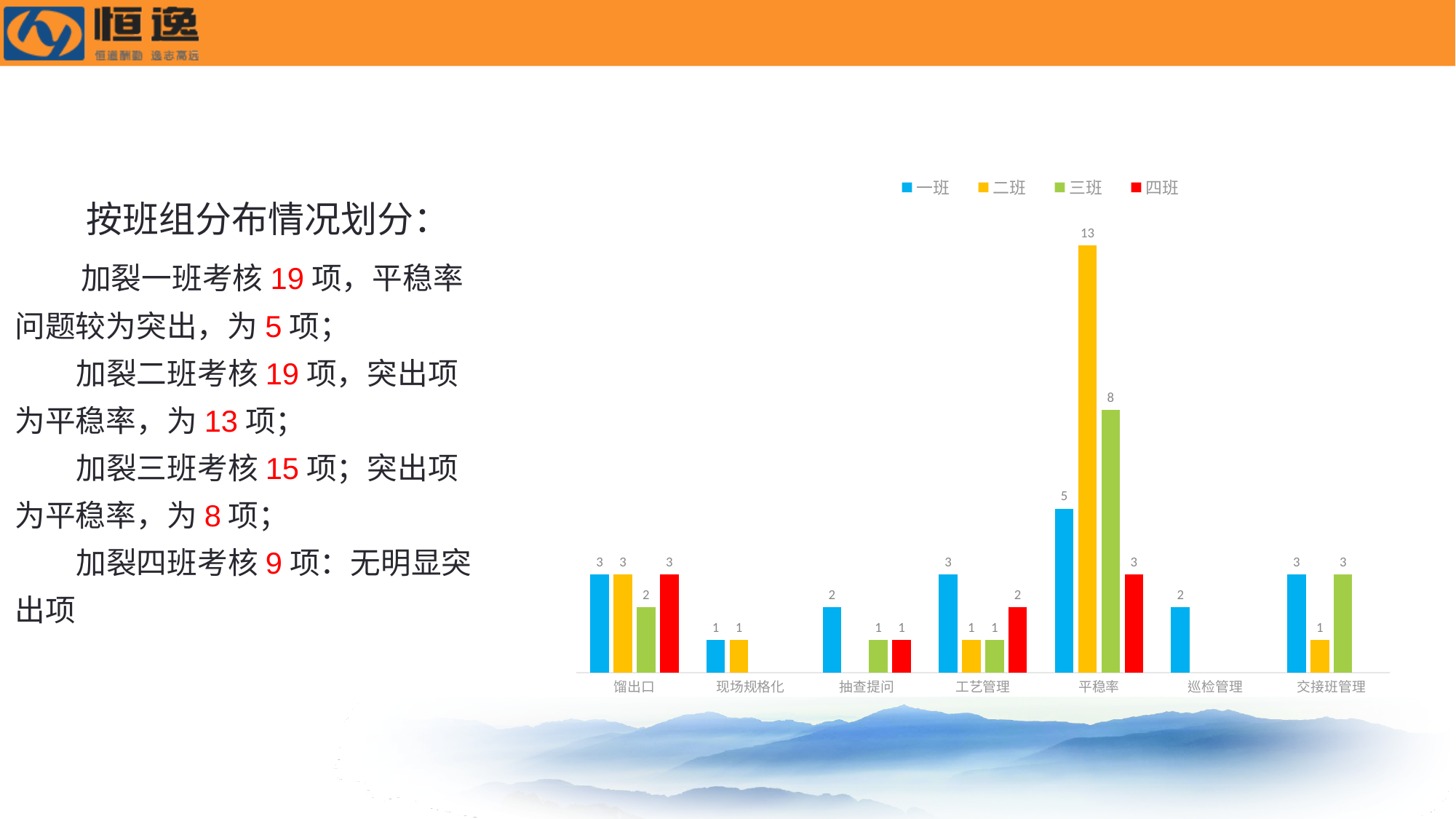
Which series is shown in red in the legend? 四班 What is the difference between the 二班 and 一班 values in the 平稳率 category? 8 How many categories are shown on the x axis? 7 How many series does the legend list? 4 What is the value for 三班 in the 平稳率 category? 8 What is the value for 二班 in the 平稳率 category? 13 Which series has the lowest value in the 馏出口 category? 三班 What is the value for 四班 in the 工艺管理 category? 2 Which is larger: the 一班 value for 抽查提问 or the 一班 value for 工艺管理? 工艺管理 Which series has the highest value in the 平稳率 category? 二班 What type of chart is shown on the slide? bar chart What is the value for 一班 in the 巡检管理 category? 2